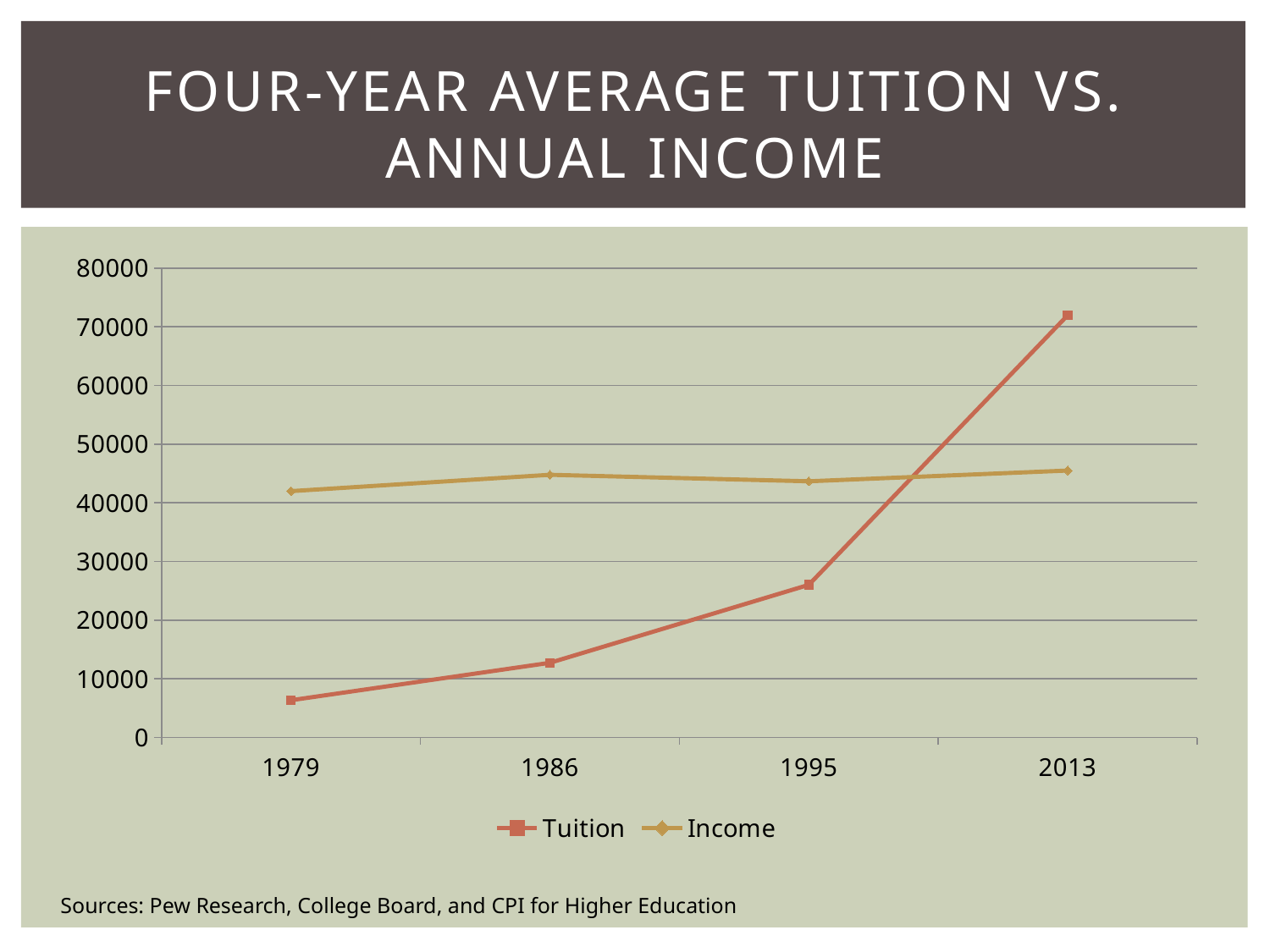
In 2013, which is larger, Tuition or Income? Tuition In which year is Tuition lowest? 1979 Is the value for Income in 1979 greater or less than 40000? greater How many series does the legend list? 2 Is the value for Tuition in 2013 greater or less than 60000? greater In 1979, which is larger, Tuition or Income? Income Does Tuition rise or fall from 1979 to 2013? rise How many years are plotted along the x axis? 4 What kind of chart is shown on the slide? line chart Is the value for Tuition in 1979 greater or less than 10000? less What is the title of the chart? Four-Year Average Tuition vs. Annual Income In which year is Tuition highest? 2013